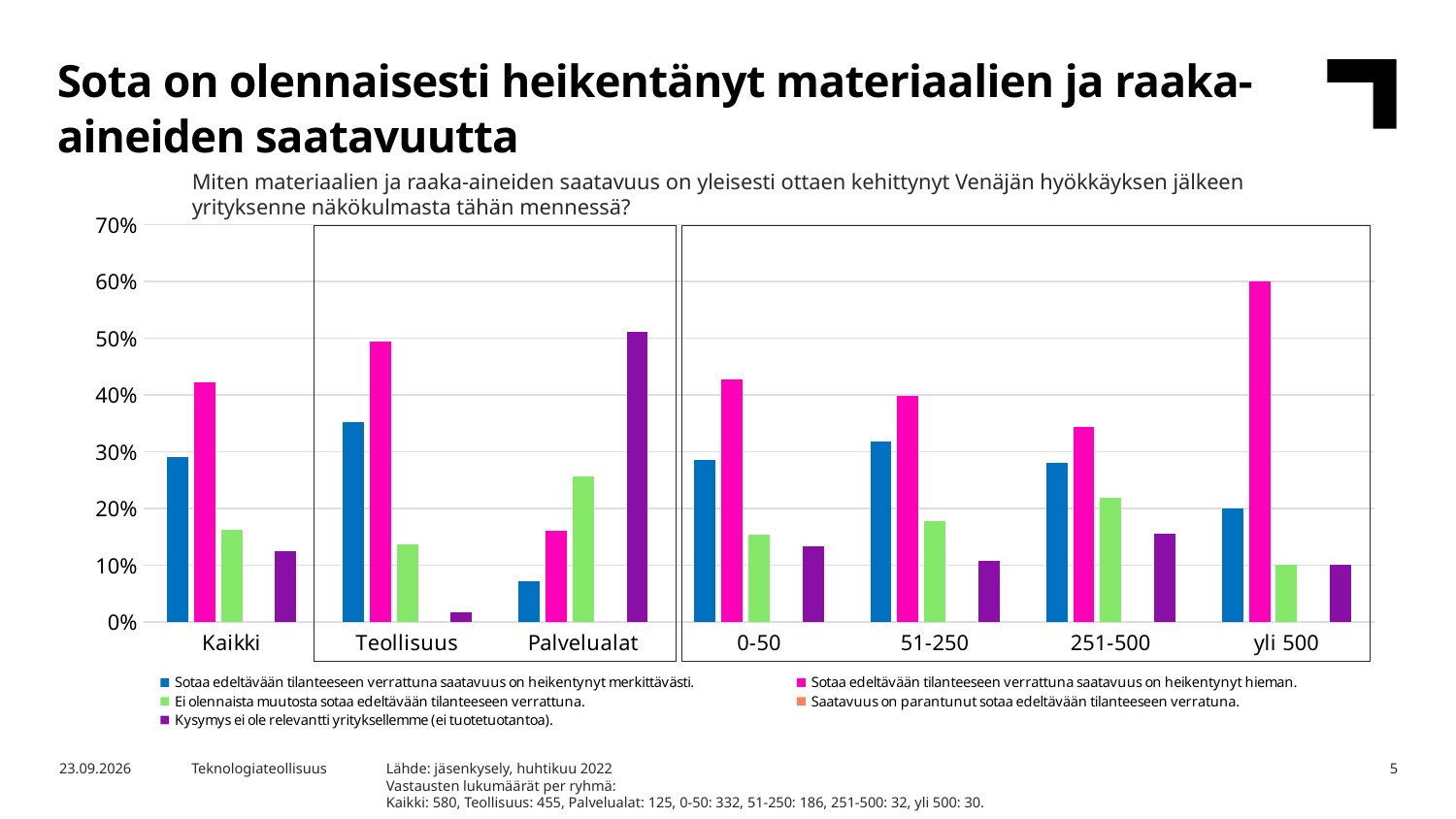
What is the maximum value shown on the chart's vertical axis? 70% In the Kaikki category, which is larger: 'heikentynyt merkittävästi' or 'Ei olennaista muutosta'? heikentynyt merkittävästi What kind of chart is shown on the slide? bar chart Which category has the highest bar for 'Sotaa edeltävään tilanteeseen verrattuna saatavuus on heikentynyt hieman'? yli 500 How many categories are shown along the x axis of the chart? 7 Is the value for 'heikentynyt hieman' in the yli 500 category greater or less than 50%? greater How many series does the chart legend list? 5 Is the value for 'heikentynyt merkittävästi' in the Palvelualat category greater or less than 10%? less In the Palvelualat category, which is larger: 'Kysymys ei ole relevantti yrityksellemme' or 'heikentynyt merkittävästi'? Kysymys ei ole relevantti yrityksellemme Which category has the lowest bar for 'Kysymys ei ole relevantti yrityksellemme (ei tuotetuotantoa)'? Teollisuus Is the value for 'heikentynyt merkittävästi' in the Teollisuus category greater or less than 30%? greater